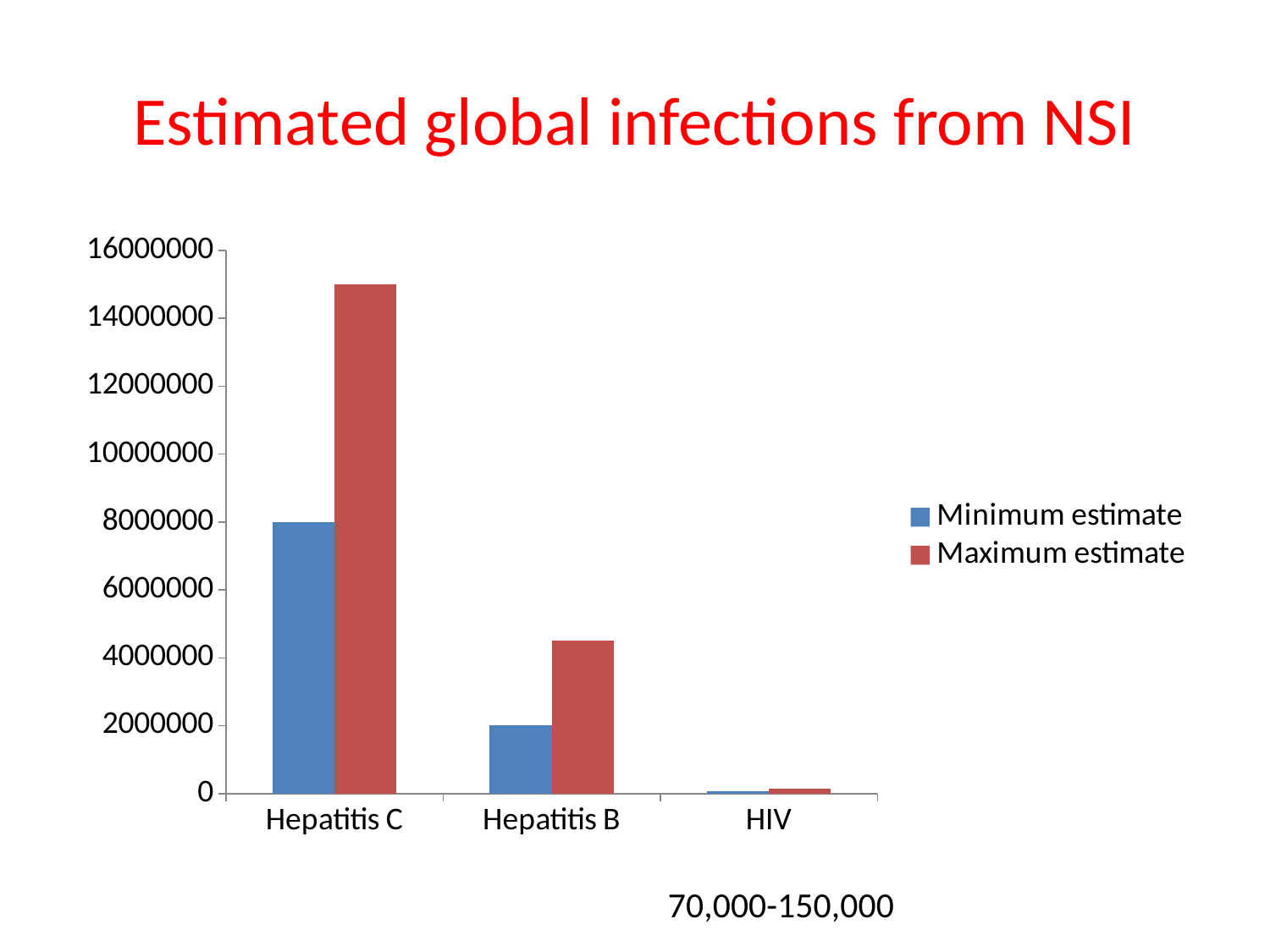
What is the title of the chart? Estimated global infections from NSI What is the difference between the minimum estimates for Hepatitis C and Hepatitis B? 6000000 What is the minimum estimate for Hepatitis C? 8000000 Is the maximum estimate for Hepatitis C greater or less than 14000000? greater How many series does the legend list? 2 What range of estimated infections is given for HIV? 70,000-150,000 How many categories are shown on the x axis? 3 What type of chart is shown on the slide? bar chart Which category has the highest maximum estimate? Hepatitis C What is the minimum estimate for Hepatitis B? 2000000 Which category has the lowest minimum estimate? HIV Is the maximum estimate for Hepatitis B greater or less than 6000000? less